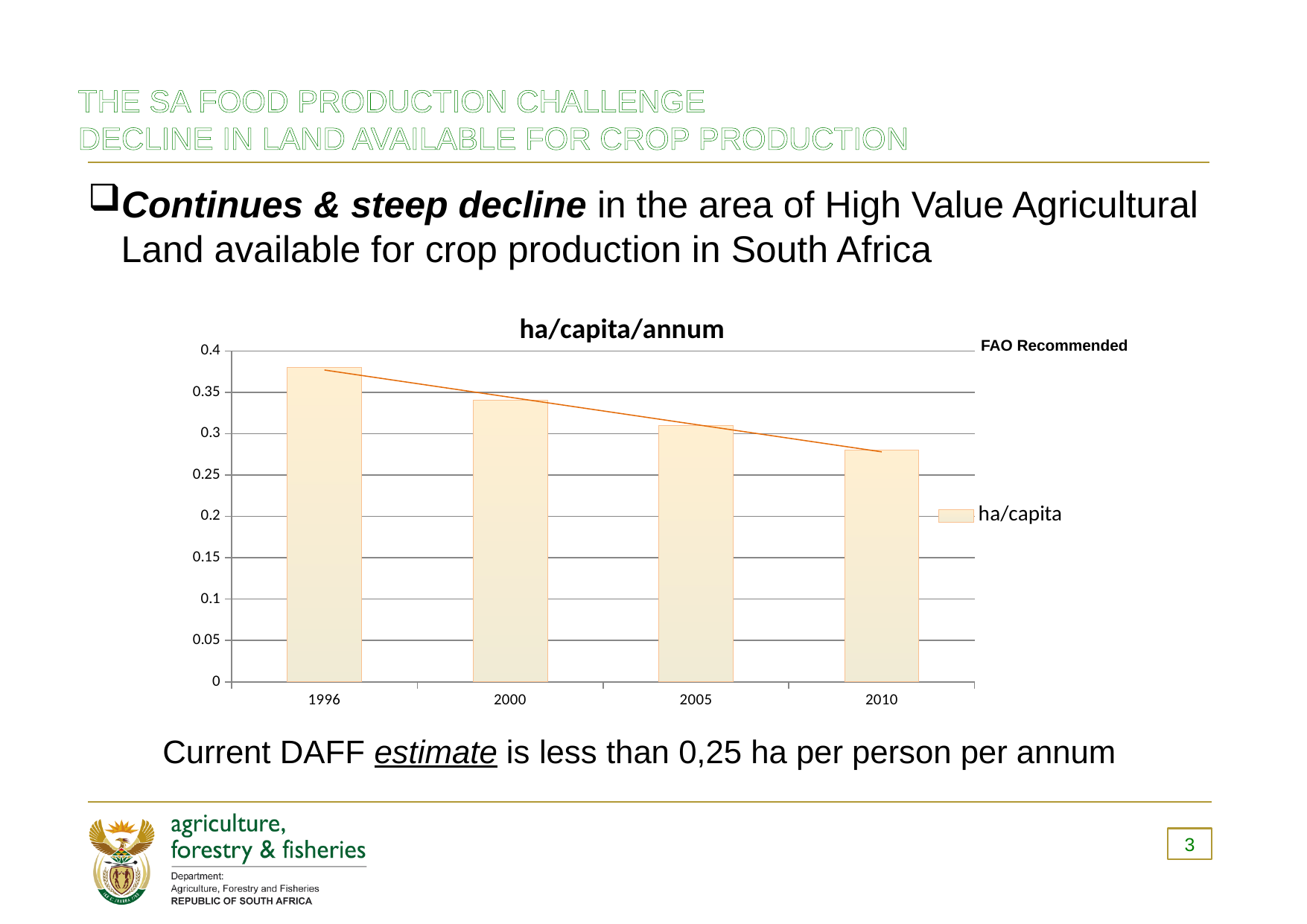
How many series does the chart legend list? 1 Is the ha/capita value for 2010 greater or less than 0.3? less Which year has the highest ha/capita value? 1996 What kind of chart is shown on the slide? bar chart How many years are shown on the x axis of the chart? 4 Which year has the lowest ha/capita value? 2010 What is the title of the chart? ha/capita/annum Which year has the larger ha/capita value, 2000 or 2005? 2000 What is the name of the series listed in the chart legend? ha/capita Do the ha/capita values rise or fall from 1996 to 2010? fall Which year has the larger ha/capita value, 1996 or 2010? 1996 Is the ha/capita value for 1996 greater or less than 0.35? greater